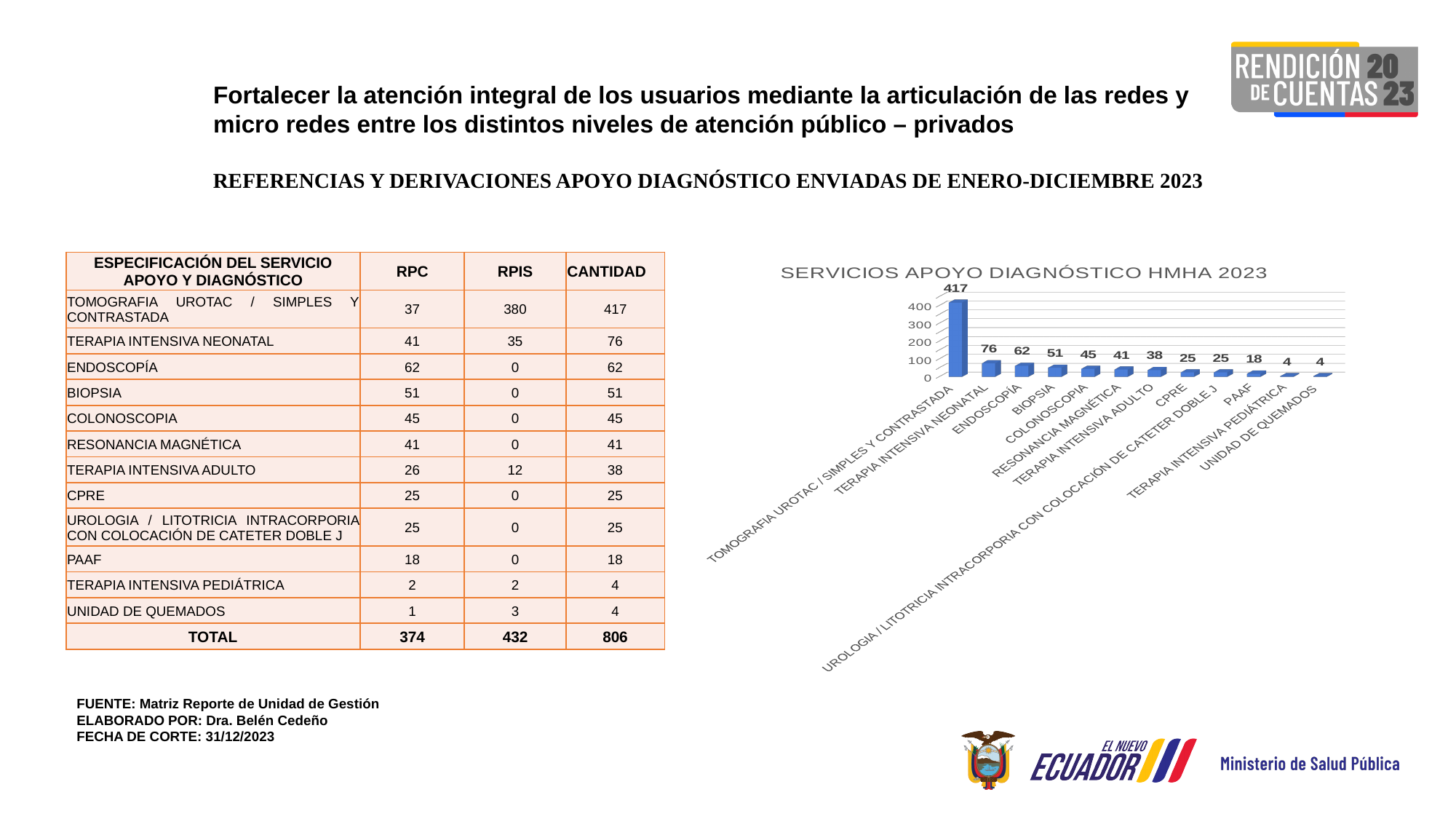
What is the value for PAAF in the chart? 18 Which category has the highest value in the chart? TOMOGRAFIA UROTAC / SIMPLES Y CONTRASTADA Do the values in the chart generally rise or fall from left to right along the x axis? fall What is the value for RESONANCIA MAGNÉTICA in the chart? 41 What is the value for TERAPIA INTENSIVA NEONATAL in the chart? 76 What is the title of the chart on the slide? SERVICIOS APOYO DIAGNÓSTICO HMHA 2023 Which is larger in the chart, the value for BIOPSIA or the value for COLONOSCOPIA? BIOPSIA What is the difference between the values for TOMOGRAFIA UROTAC / SIMPLES Y CONTRASTADA and TERAPIA INTENSIVA NEONATAL? 341 What is the value for ENDOSCOPÍA in the chart? 62 Is the value for TERAPIA INTENSIVA ADULTO greater or less than 100? less What type of chart is shown on the slide? bar chart How many categories are plotted in the chart? 12